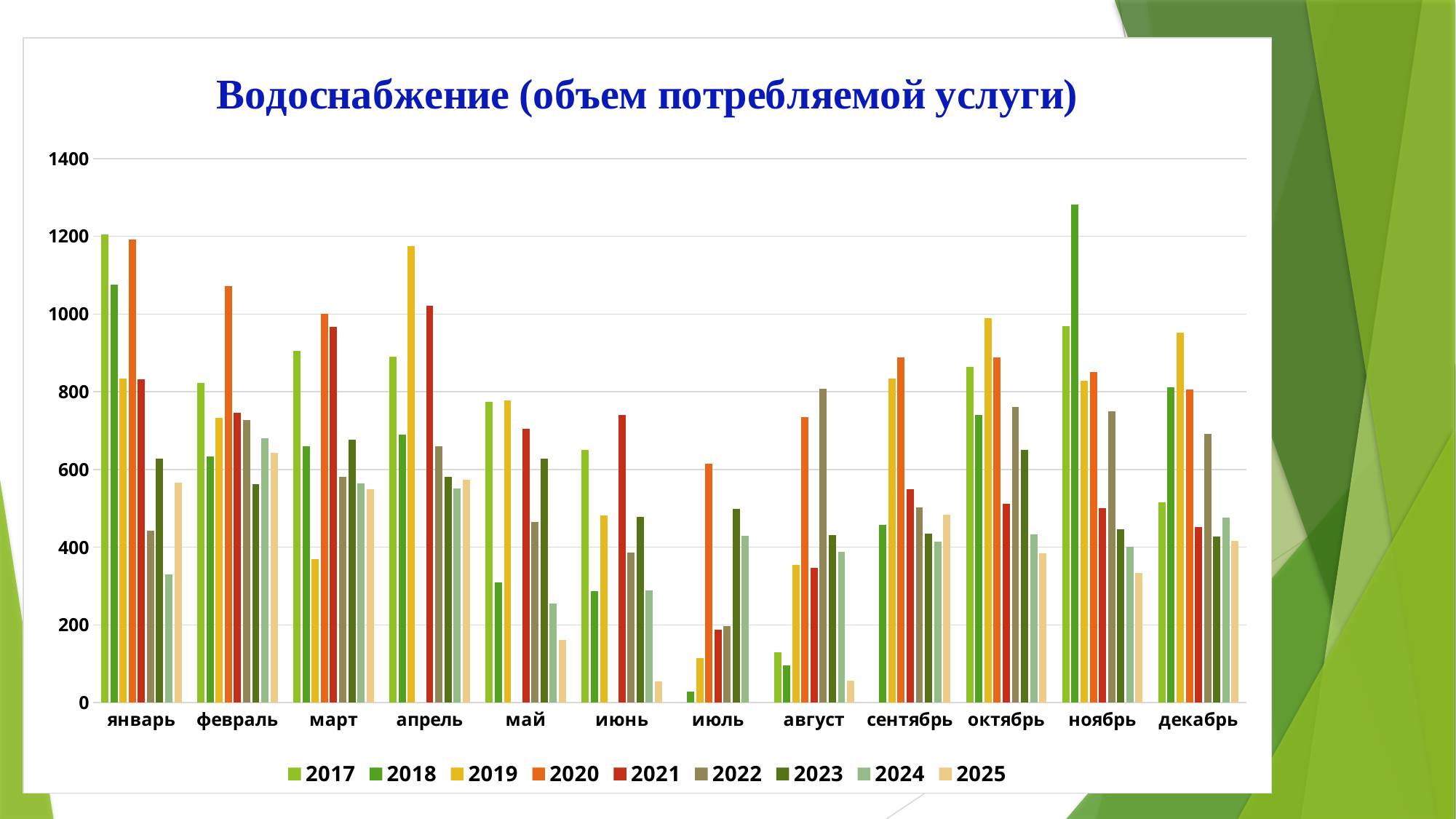
Is the value for 2024 in январь greater or less than 400? less In июль, which is larger: the 2020 value or the 2023 value? 2020 In январь, which is larger: the 2017 value or the 2018 value? 2017 In which month is the 2018 bar the highest? ноябрь How many series does the legend list? 9 What kind of chart is shown on the slide? bar chart In which month is the 2019 bar the highest? апрель Is the value for 2020 in сентябрь greater or less than 800? greater In which month is the 2018 bar the lowest? июль How many months (categories) are shown on the x axis? 12 Is the value for 2018 in ноябрь greater or less than 1200? greater What is the title of the chart? Водоснабжение (объем потребляемой услуги)